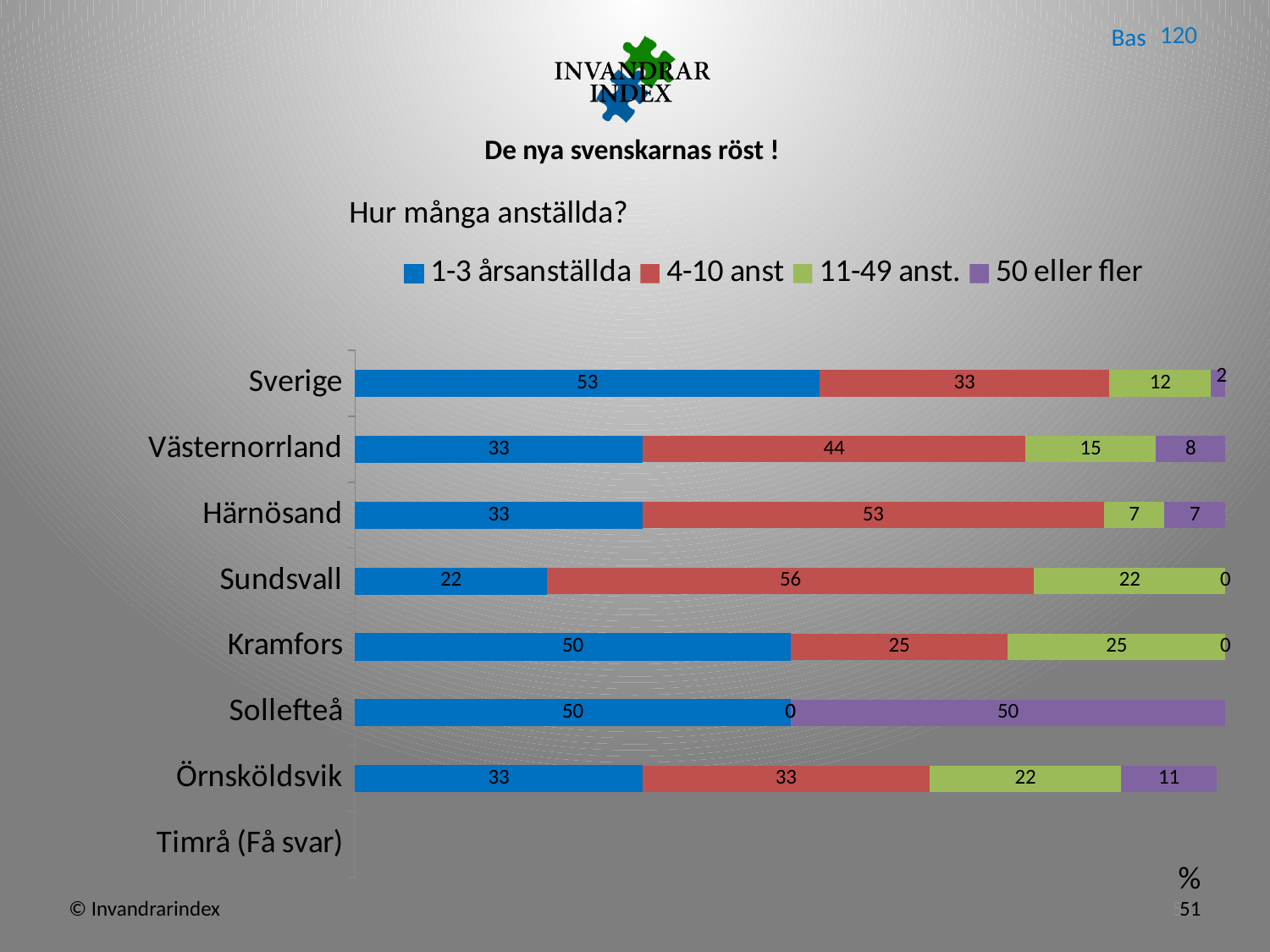
What is the total of the stacked bar for Härnösand? 100 What kind of chart is shown on the slide? stacked bar chart What is the value for 11-49 anst. for Örnsköldsvik? 22 What is the value for 50 eller fler for Västernorrland? 8 Which is larger: the 1-3 årsanställda value for Kramfors or for Västernorrland? Kramfors Which category has the highest value for 4-10 anst? Sundsvall What is the difference between the 4-10 anst values for Härnösand and Sverige? 20 How many series does the legend list? 4 What is the value for 4-10 anst for Sundsvall? 56 What is the value for 1-3 årsanställda for Sverige? 53 Which category on the axis has no bar plotted? Timrå (Få svar) Which category has the lowest value for 1-3 årsanställda among those with data? Sundsvall